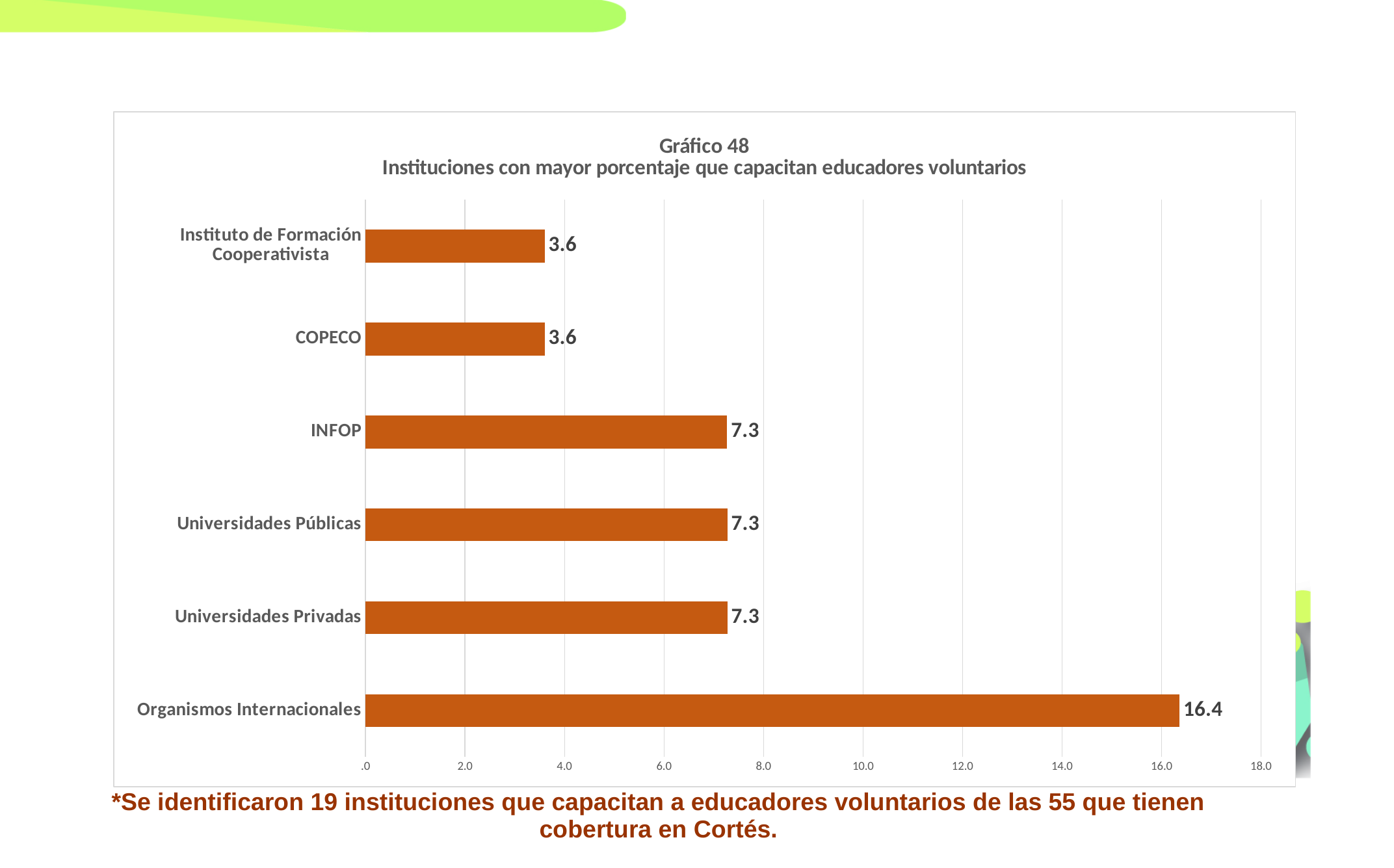
What kind of chart is shown on the slide? bar chart Which is larger, the value for Universidades Públicas or the value for COPECO? Universidades Públicas What is the difference between the values for Organismos Internacionales and Universidades Privadas? 9.1 What is the value for COPECO? 3.6 What is the title of the chart? Gráfico 48 Instituciones con mayor porcentaje que capacitan educadores voluntarios What is the difference between the values for INFOP and COPECO? 3.7 How many categories are shown in the chart? 6 Is the value for Organismos Internacionales greater or less than 14.0? greater Which category has the highest value? Organismos Internacionales What is the value for Organismos Internacionales? 16.4 What is the value for Instituto de Formación Cooperativista? 3.6 What is the value for INFOP? 7.3